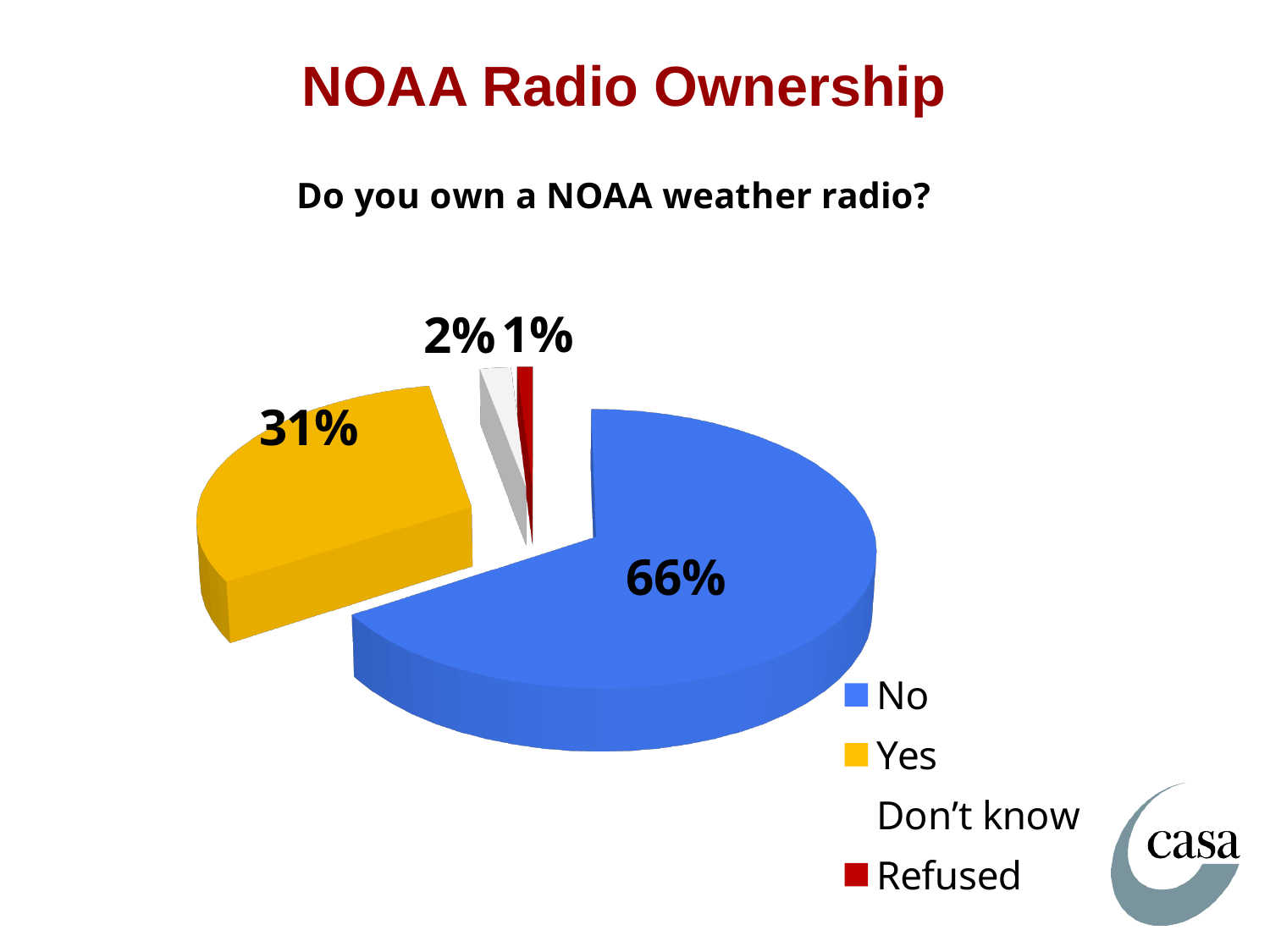
What share of the pie is labelled "Don't know"? 2% Which response has the smallest slice of the pie? Refused What is the difference in percentage points between the "No" and "Yes" slices? 35 What kind of chart is shown on the slide? Pie chart How many entries does the legend list? 4 How many slices does the pie chart have? 4 Which response has the largest slice of the pie? No Which is larger, the "Yes" slice or the "Don't know" slice? Yes What percentage of respondents answered "No" to owning a NOAA weather radio? 66% What colour is the "Yes" slice? Yellow What share of the pie is labelled "Refused"? 1% What percentage of respondents answered "Yes"? 31%